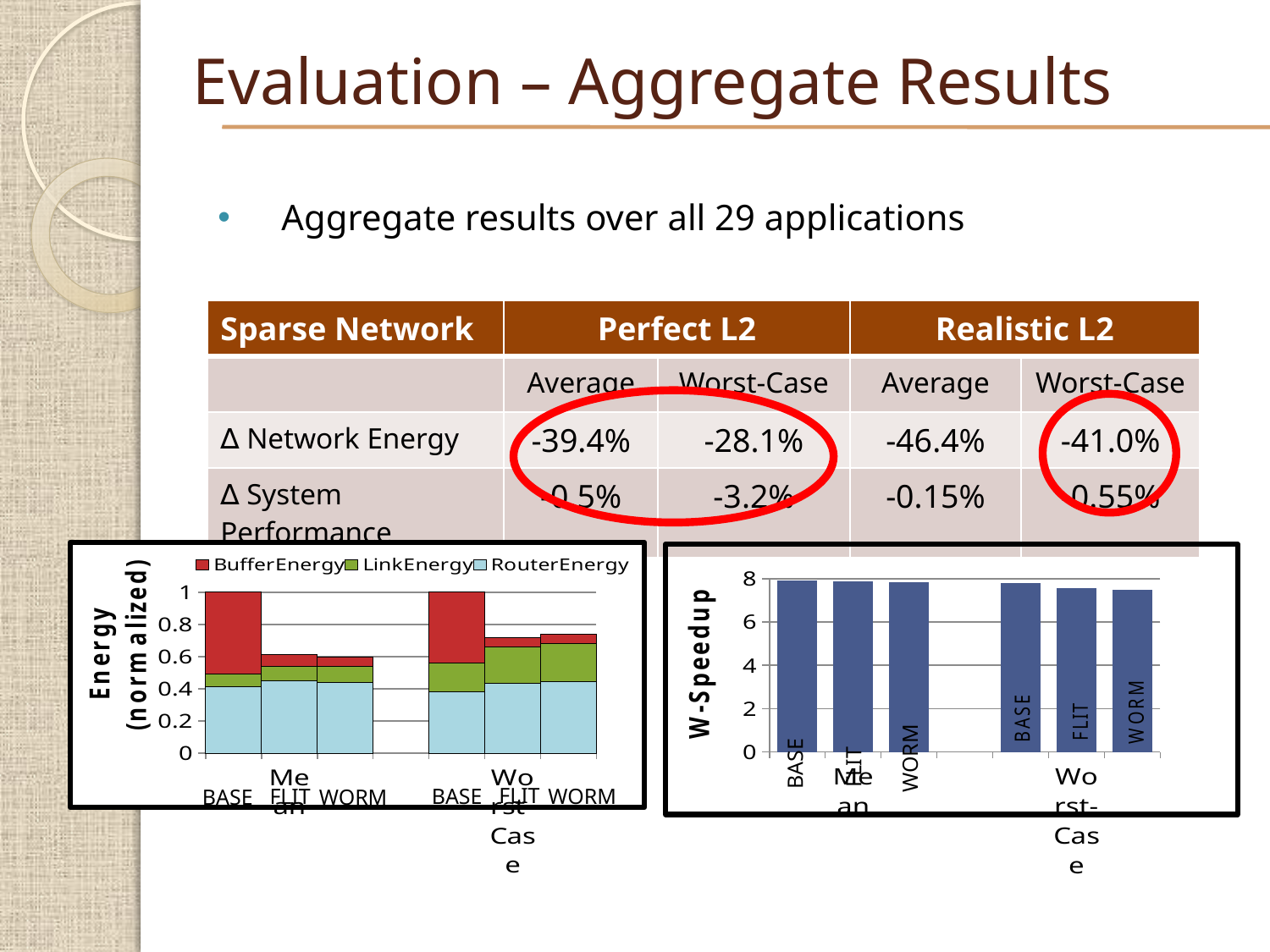
In the left chart (Energy normalized), what are the three legend entries? BufferEnergy, LinkEnergy, RouterEnergy What kind of chart is the right chart (W-Speedup)? bar chart In the left chart (Energy normalized), which colour represents BufferEnergy? red In the left chart (Energy normalized), what is the total normalized energy of the BASE bar in the Mean group? 1 In the left chart (Energy normalized), is the total energy for FLIT in the Mean group greater or less than 0.8? less In the right chart (W-Speedup), is the value for BASE in the Mean group greater or less than 6? greater In the left chart (Energy normalized), which configuration has the highest total energy in the Mean group? BASE In the left chart (Energy normalized), how many stacked bars are plotted? 6 In the right chart (W-Speedup), how many bars are plotted? 6 In the left chart (Energy normalized), is the total energy for FLIT in the Worst-Case group greater or less than 0.6? greater In the left chart (Energy normalized), how many series does the legend list? 3 What kind of chart is the left chart (Energy normalized)? stacked bar chart